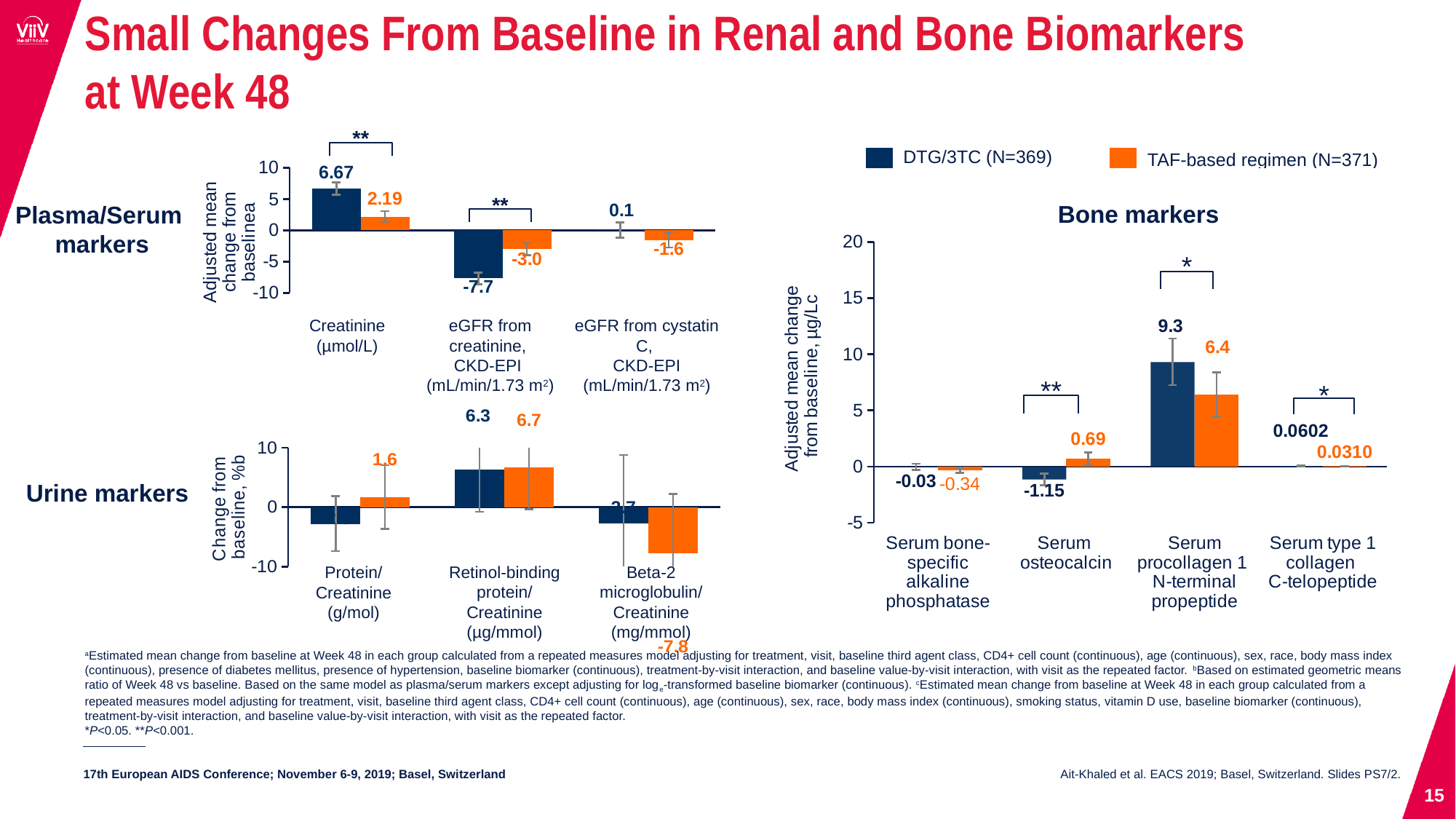
In the Plasma/Serum markers chart, what is the adjusted mean change from baseline in creatinine for the DTG/3TC group? 6.67 In the Bone markers chart, what is the adjusted mean change from baseline for serum procollagen 1 N-terminal propeptide in the DTG/3TC group? 9.3 In the Urine markers chart, what is the change from baseline for retinol-binding protein/creatinine in the TAF-based regimen group? 6.7 In the Plasma/Serum markers chart, is the DTG/3TC value for eGFR from creatinine (CKD-EPI) greater or less than -5? less How many treatment groups does the legend list? 2 How many bone markers are shown on the x axis of the Bone markers chart? 4 In the Bone markers chart, which group has the larger value for serum procollagen 1 N-terminal propeptide, DTG/3TC or TAF-based regimen? DTG/3TC What type of chart is the Bone markers chart? Bar chart In the Plasma/Serum markers chart, what is the value for eGFR from creatinine (CKD-EPI) in the TAF-based regimen group? -3.0 In the Plasma/Serum markers chart, what is the difference between the DTG/3TC and TAF-based regimen values for creatinine? 4.48 In the Bone markers chart, which bone marker has the highest value for the DTG/3TC group? Serum procollagen 1 N-terminal propeptide In the Bone markers chart, what is the value for serum osteocalcin in the TAF-based regimen group? 0.69